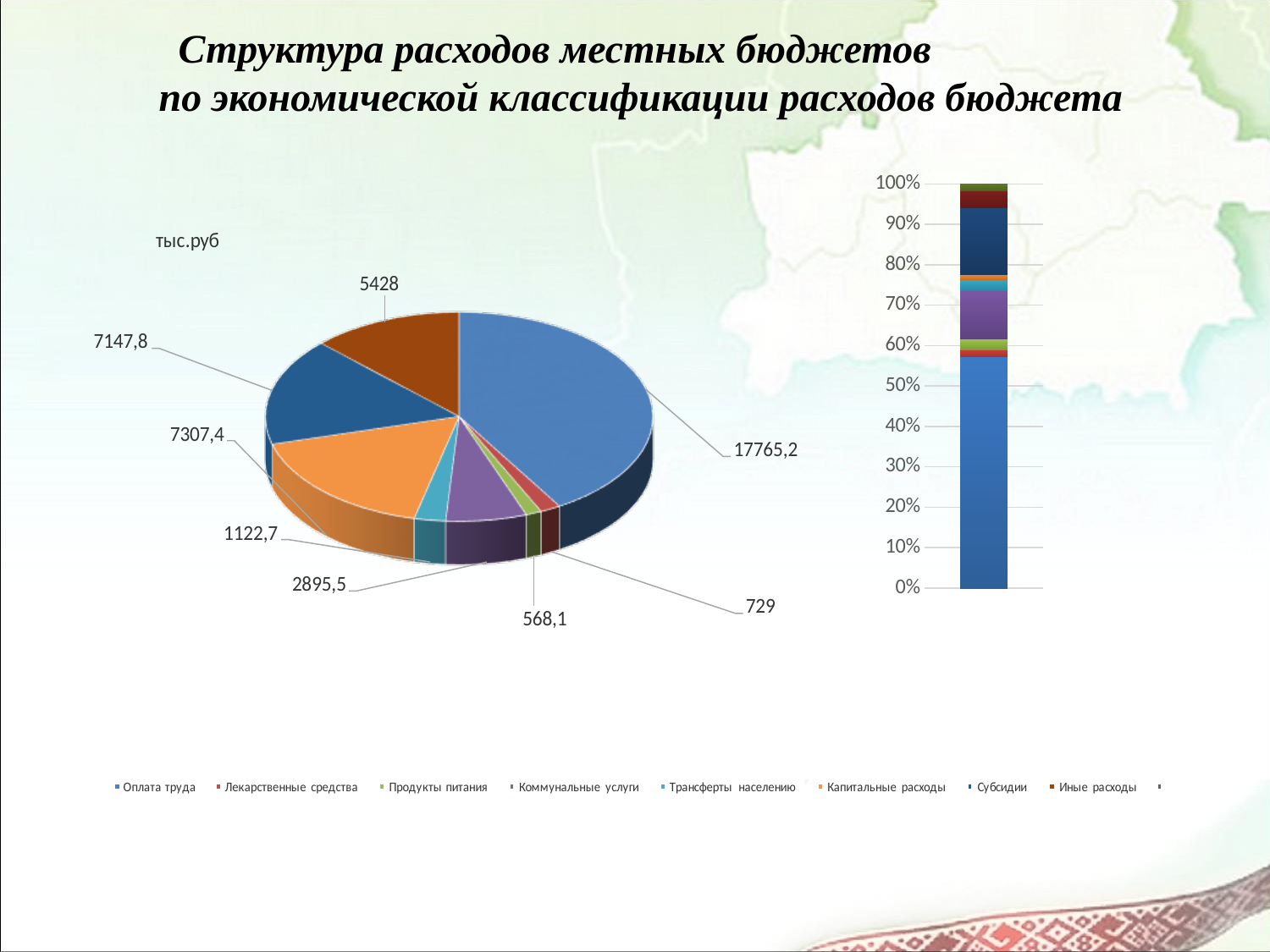
In the pie chart, which is larger: Трансферты населению or Коммунальные услуги? Коммунальные услуги In the pie chart, which category has the smallest value? Продукты питания In the pie chart, what is the difference between Капитальные расходы and Субсидии? 159,6 In the pie chart, what unit is shown above the chart? тыс.руб In the pie chart, what is the value for Оплата труда? 17765,2 In the pie chart, what is the value for Иные расходы? 5428 What kind of chart is the chart on the left of the slide? Pie chart In the pie chart, which category has the largest value? Оплата труда In the pie chart, what is the difference between Лекарственные средства and Продукты питания? 160,9 In the pie chart, what is the value for Капитальные расходы? 7307,4 In the pie chart, what is the value for Коммунальные услуги? 2895,5 How many slices does the pie chart have? 8